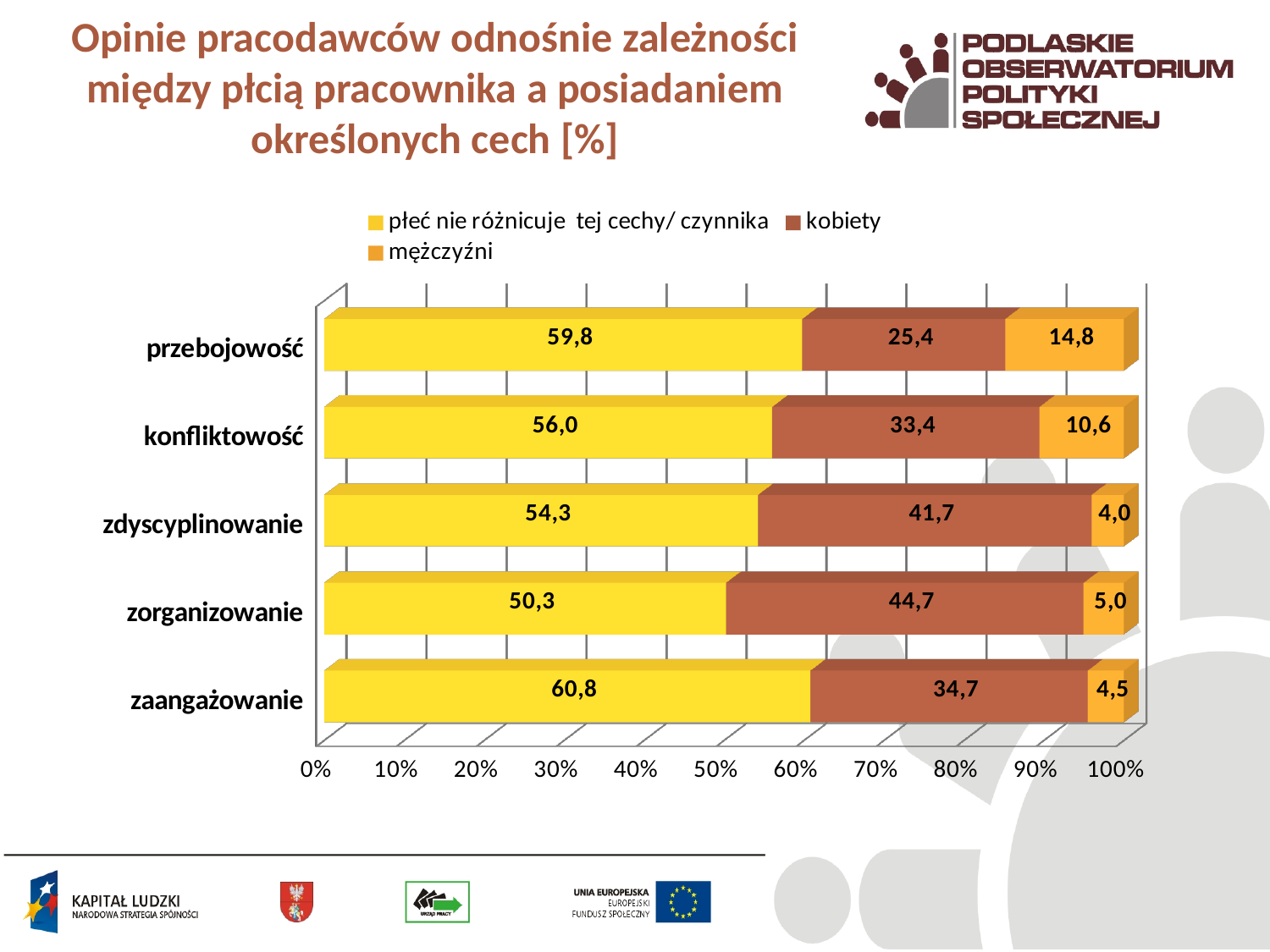
Which category has the lowest value for 'mężczyźni'? zdyscyplinowanie What kind of chart is shown on the slide? stacked bar chart What is the value for 'płeć nie różnicuje tej cechy/ czynnika' in the 'zorganizowanie' category? 50,3 Which category has the highest value for 'płeć nie różnicuje tej cechy/ czynnika'? zaangażowanie What is the difference between the 'kobiety' values for 'konfliktowość' and 'przebojowość'? 8,0 How many series does the legend list? 3 How many categories are shown on the chart? 5 What is the value for 'mężczyźni' in the 'konfliktowość' category? 10,6 What is the total of the stacked bar for 'zdyscyplinowanie'? 100,0 Which is larger: the 'mężczyźni' value for 'przebojowość' or for 'zaangażowanie'? przebojowość What is the value for 'kobiety' in the 'przebojowość' category? 25,4 Which category has the highest value for 'kobiety'? zorganizowanie